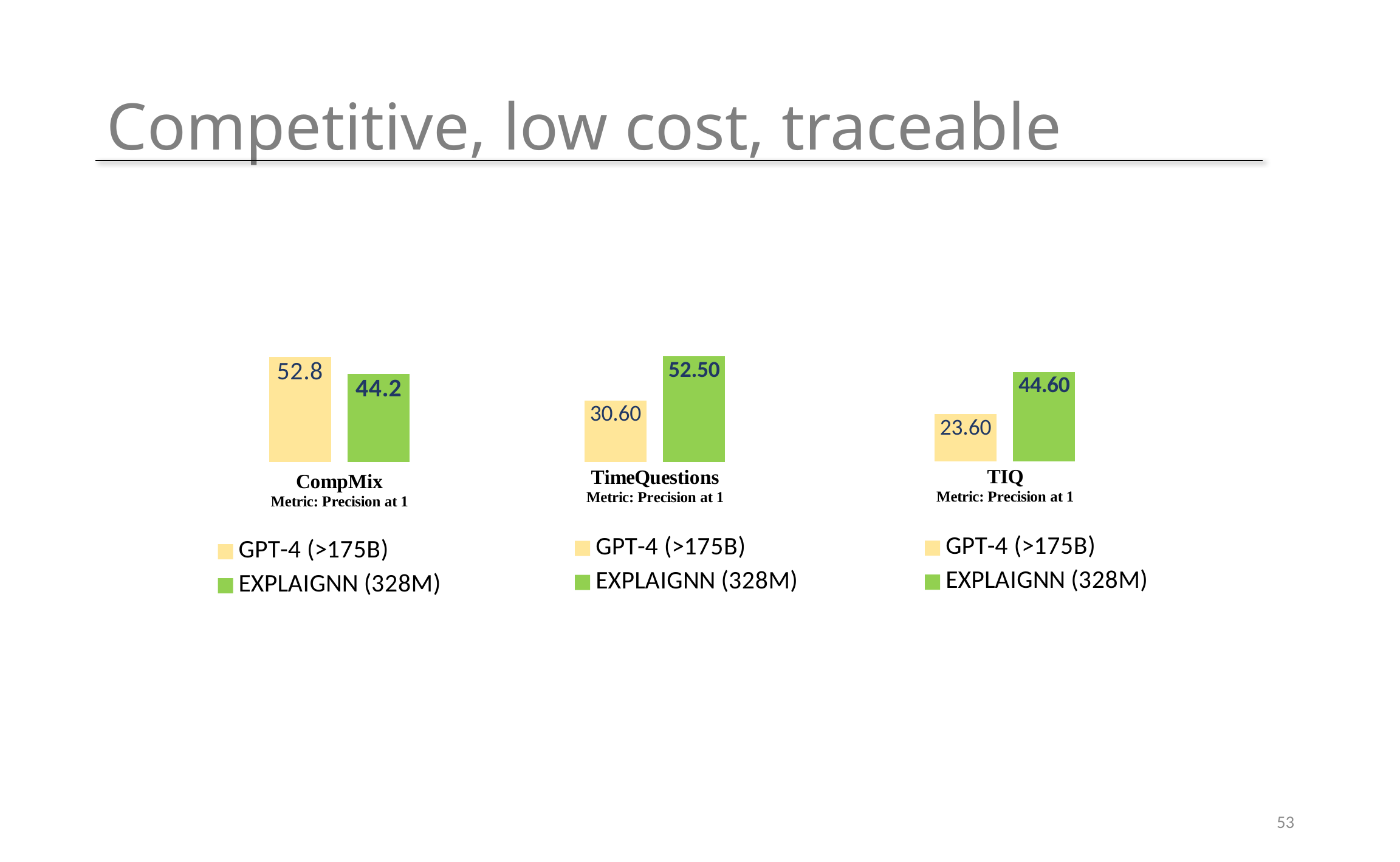
In the TIQ chart, what is the value for GPT-4 (>175B)? 23.60 In the TimeQuestions chart, what is the difference between the EXPLAIGNN (328M) value and the GPT-4 (>175B) value? 21.90 In the TIQ chart, what is the difference between the EXPLAIGNN (328M) value and the GPT-4 (>175B) value? 21.00 In the CompMix chart, what is the value for EXPLAIGNN (328M)? 44.2 In the CompMix chart, what is the value for GPT-4 (>175B)? 52.8 In the TIQ chart, what is the value for EXPLAIGNN (328M)? 44.60 In the CompMix chart, which series has the higher value? GPT-4 (>175B) What kind of chart is the TimeQuestions chart? Bar chart In the TimeQuestions chart, what is the value for GPT-4 (>175B)? 30.60 In the TimeQuestions chart, what is the value for EXPLAIGNN (328M)? 52.50 How many series does the legend of the CompMix chart list? 2 In the TIQ chart, which series has the lower value? GPT-4 (>175B)